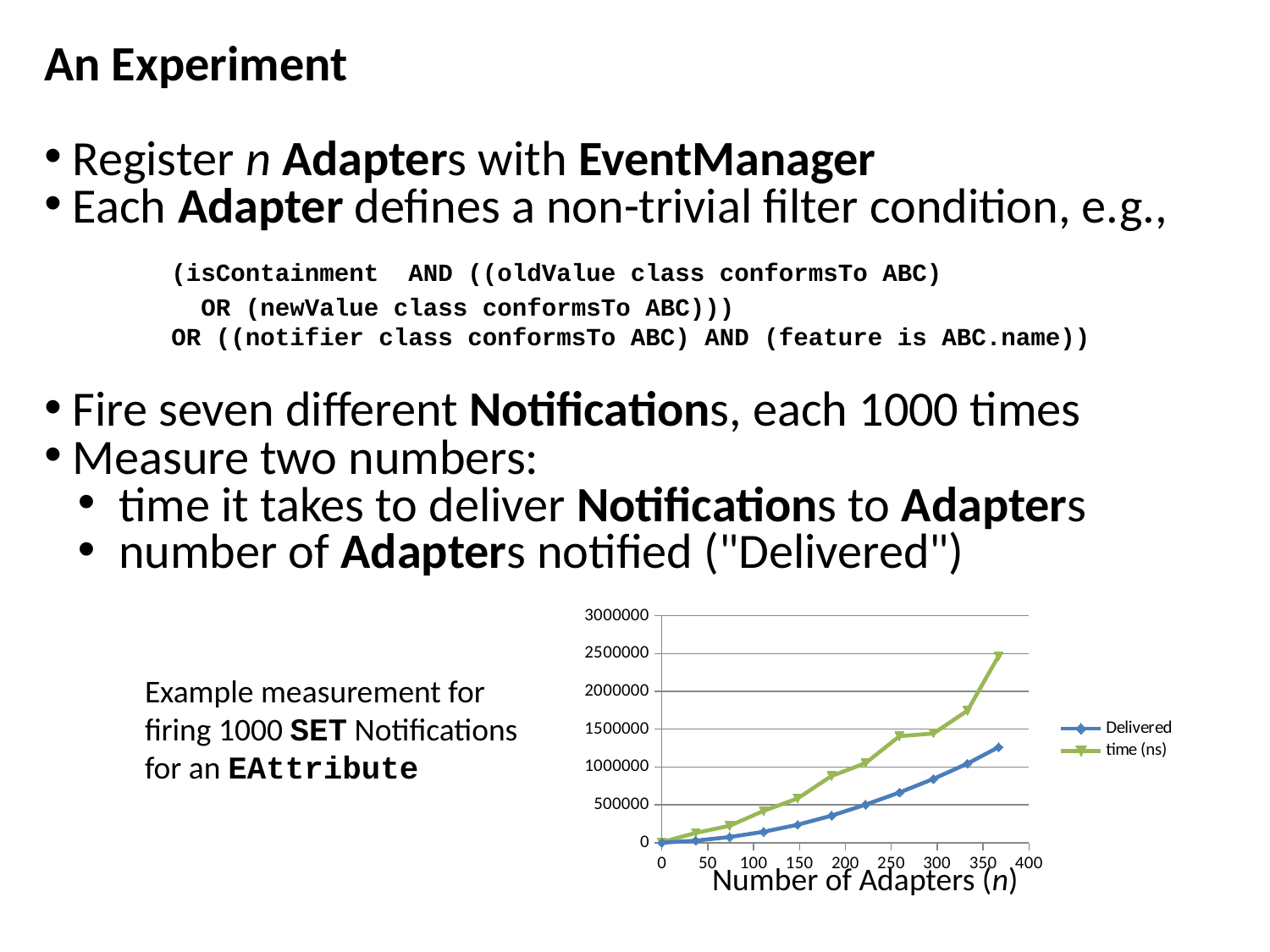
At the largest number of adapters plotted, is the time (ns) value greater or less than 2000000? greater What kind of chart is shown on the slide? line chart What is the title of the chart's x axis? Number of Adapters (n) At about 300 adapters, which series has the larger value, Delivered or time (ns)? time (ns) Which series reaches the highest value on the chart? time (ns) Does the Delivered series rise or fall as the number of adapters increases? rise At about 150 adapters, is the Delivered value greater or less than 500000? less At the largest number of adapters plotted, is the Delivered value greater or less than 1000000? greater How many series does the chart legend list? 2 Does the time (ns) series rise or fall as the number of adapters increases? rise What are the two series named in the chart legend? Delivered and time (ns) What is the maximum value shown on the chart's y axis? 3000000